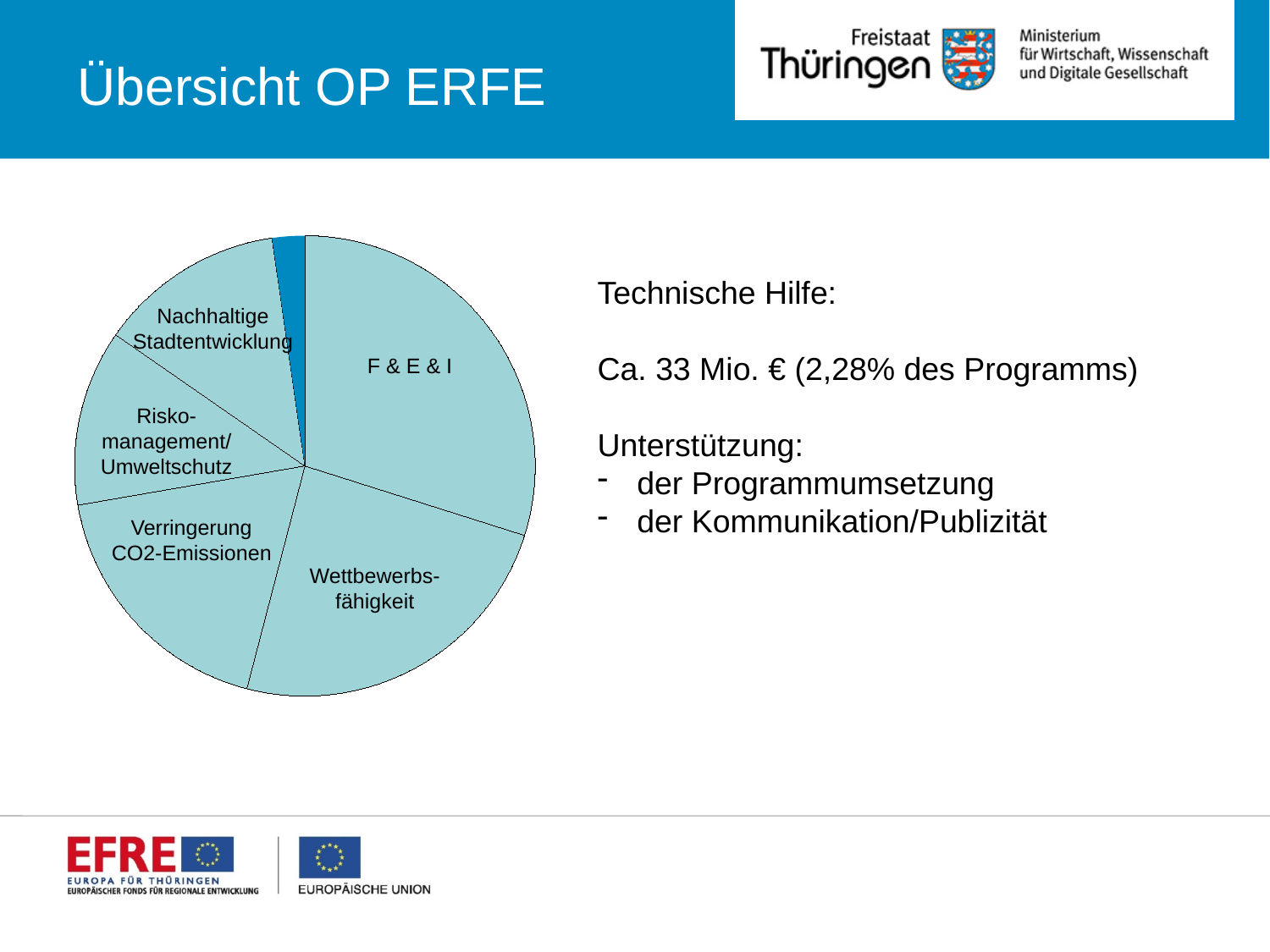
Which slice is larger: F & E & I or Wettbewerbsfähigkeit? F & E & I Which slice is larger: Wettbewerbsfähigkeit or Riskomanagement/Umweltschutz? Wettbewerbsfähigkeit How many labelled slices does the pie chart have? 5 What kind of chart is shown on the slide? pie chart What colour are the labelled slices of the pie chart? light blue Which slice of the pie chart is the largest? F & E & I Which slice is larger: Verringerung CO2-Emissionen or Nachhaltige Stadtentwicklung? Verringerung CO2-Emissionen What colour is the small unlabelled slice of the pie chart? dark blue How many slices does the pie chart have in total, including the unlabelled one? 6